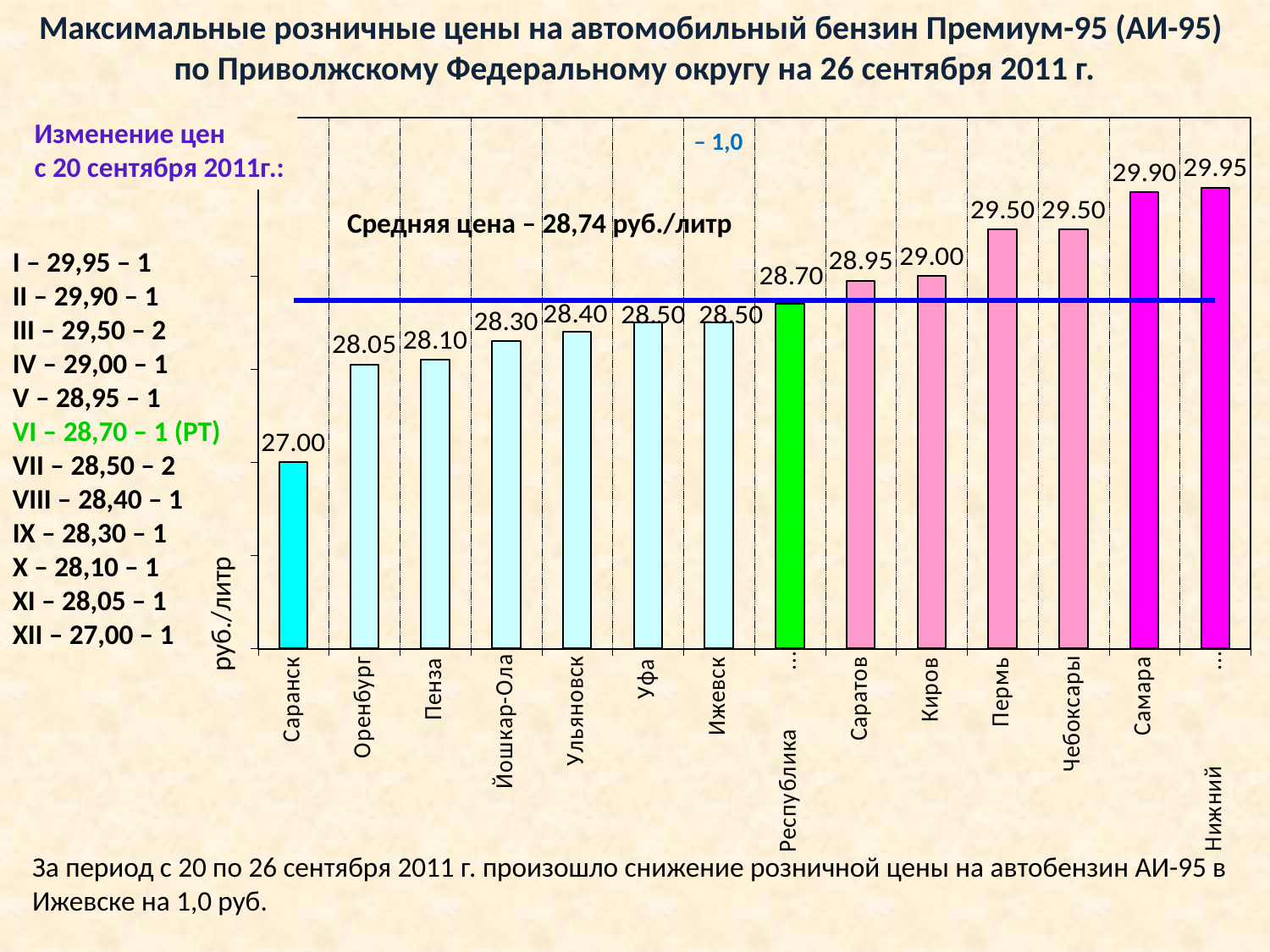
What is the value shown for Саратов? 28.95 What is the difference between the values for Самара and Оренбург? 1.85 What is the maximum retail price shown for Саранск? 27.00 How many bars are plotted on the chart? 14 What average price is stated on the chart? 28,74 руб./литр What is the value shown for Пермь? 29.50 Which city has the lowest price on the chart? Саранск Do the values generally rise or fall from left to right along the x axis? rise What is the difference between the values for Киров and Пенза? 0.90 Which has a higher value, Уфа or Чебоксары? Чебоксары What is the value shown for Йошкар-Ола? 28.30 What type of chart is shown on the slide? bar chart